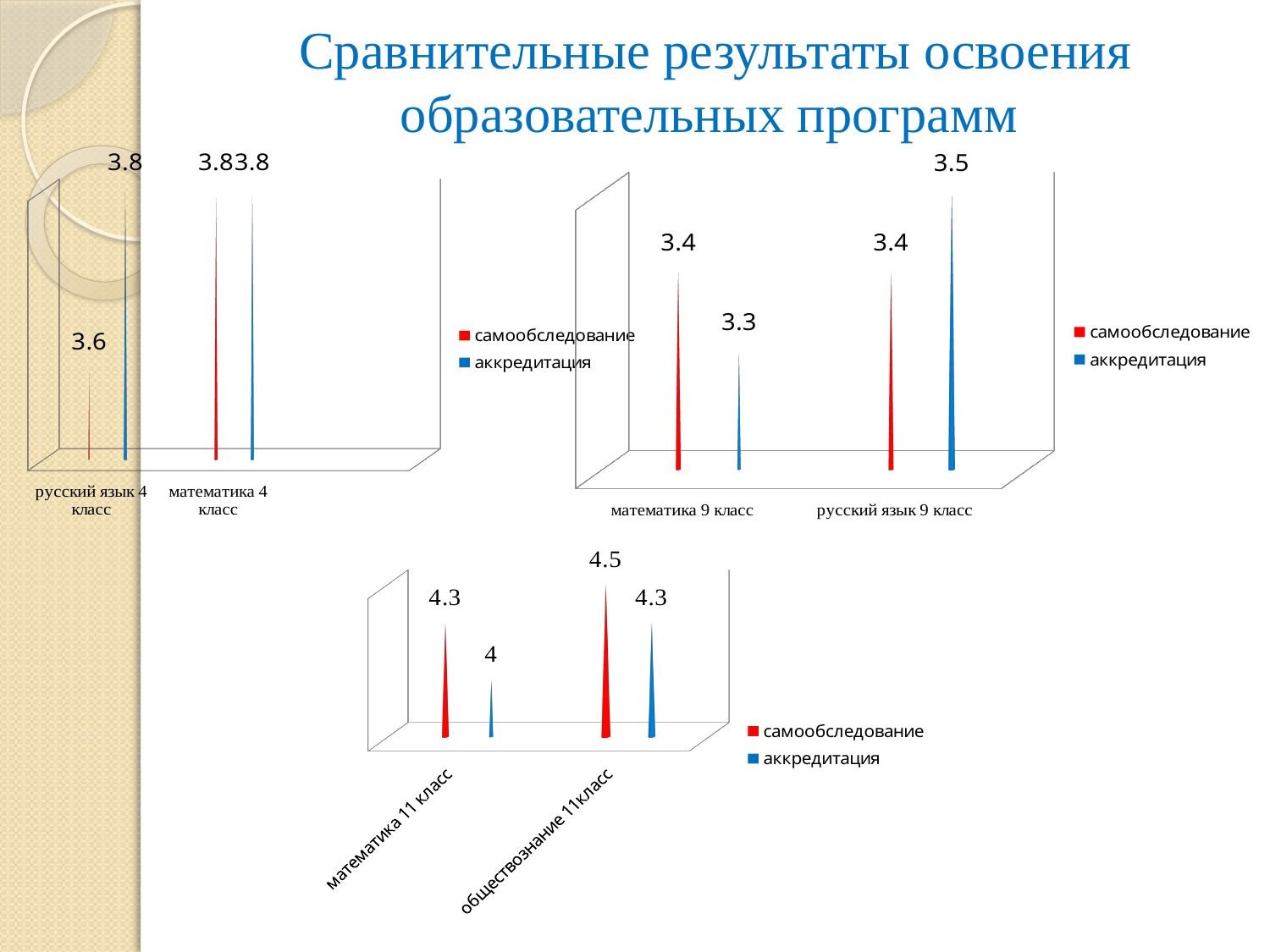
In the bottom chart, what is the difference between the самообследование and аккредитация values for математика 11 класс? 0.3 In the bottom chart, what is the самообследование value for обществознание 11класс? 4.5 What type of chart is the top-right chart? bar chart In the top-left chart, what is the аккредитация value for математика 4 класс? 3.8 In the top-right chart, what is the аккредитация value for русский язык 9 класс? 3.5 In the top-left chart, what is the самообследование value for русский язык 4 класс? 3.6 How many series does the legend of the bottom chart list? 2 In the top-right chart, which is larger for математика 9 класс: самообследование or аккредитация? самообследование In the top-left chart, what is the difference between the аккредитация and самообследование values for русский язык 4 класс? 0.2 In the top-right chart, what is the аккредитация value for математика 9 класс? 3.3 In the bottom chart, which category has the highest самообследование value? обществознание 11класс In the bottom chart, what is the аккредитация value for математика 11 класс? 4